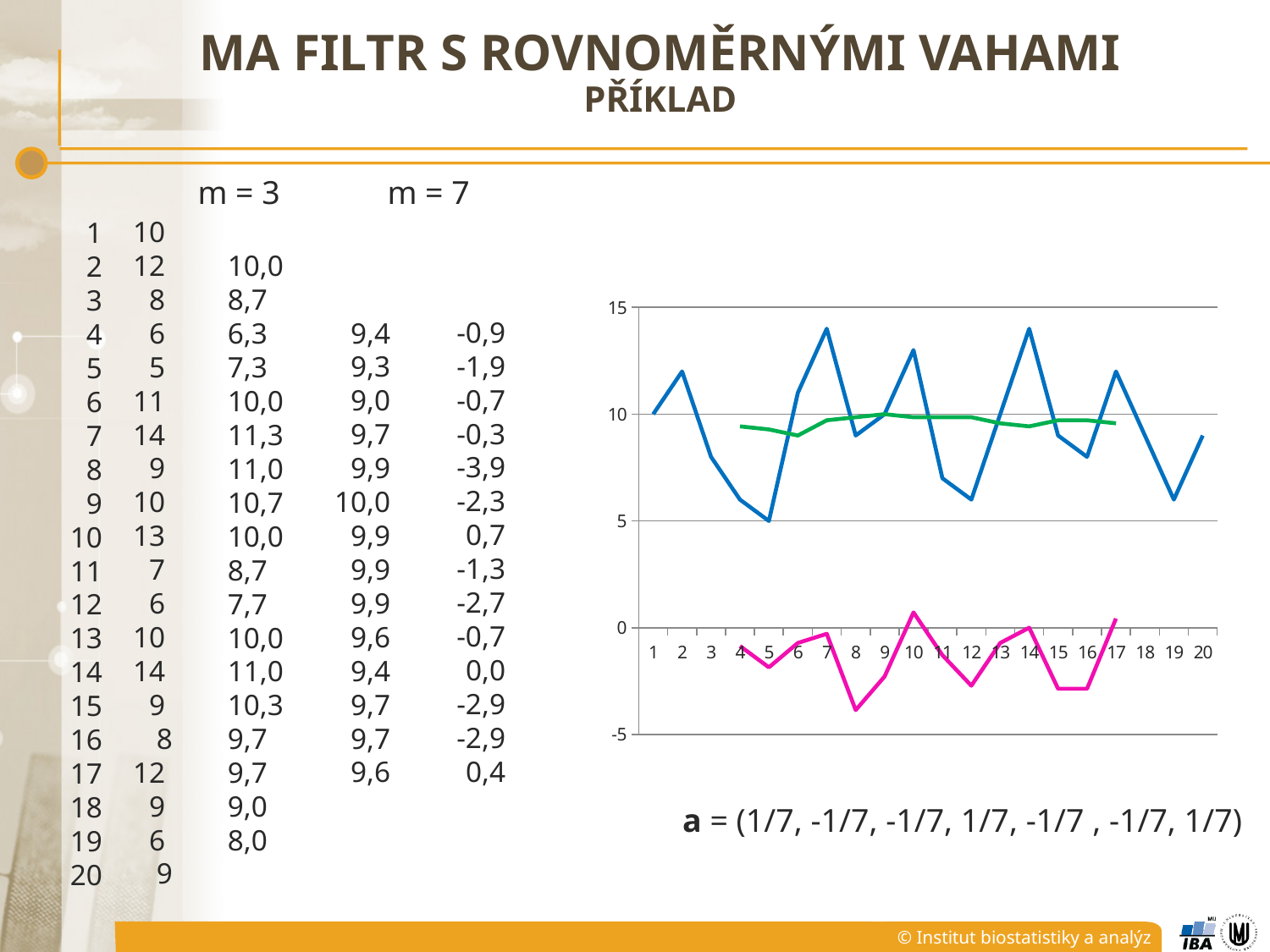
At which x value does the magenta line reach its highest point? 10 Which is larger: the blue line's value at x = 7 or at x = 12? x = 7 Is the value of the magenta line at x = 8 greater or less than 0? less What is the value of the blue line at x = 5? 5 At which x value does the blue line reach its lowest point? 5 What is the difference between the blue line's value at x = 1 and at x = 5? 5 What is the value of the blue line at x = 1? 10 Does the blue line rise or fall from x = 2 to x = 5? fall What kind of chart is shown on the slide? line chart At which x value does the magenta line reach its lowest point? 8 Is the value of the blue line at x = 7 greater or less than 10? greater How many points are marked along the x axis of the chart? 20